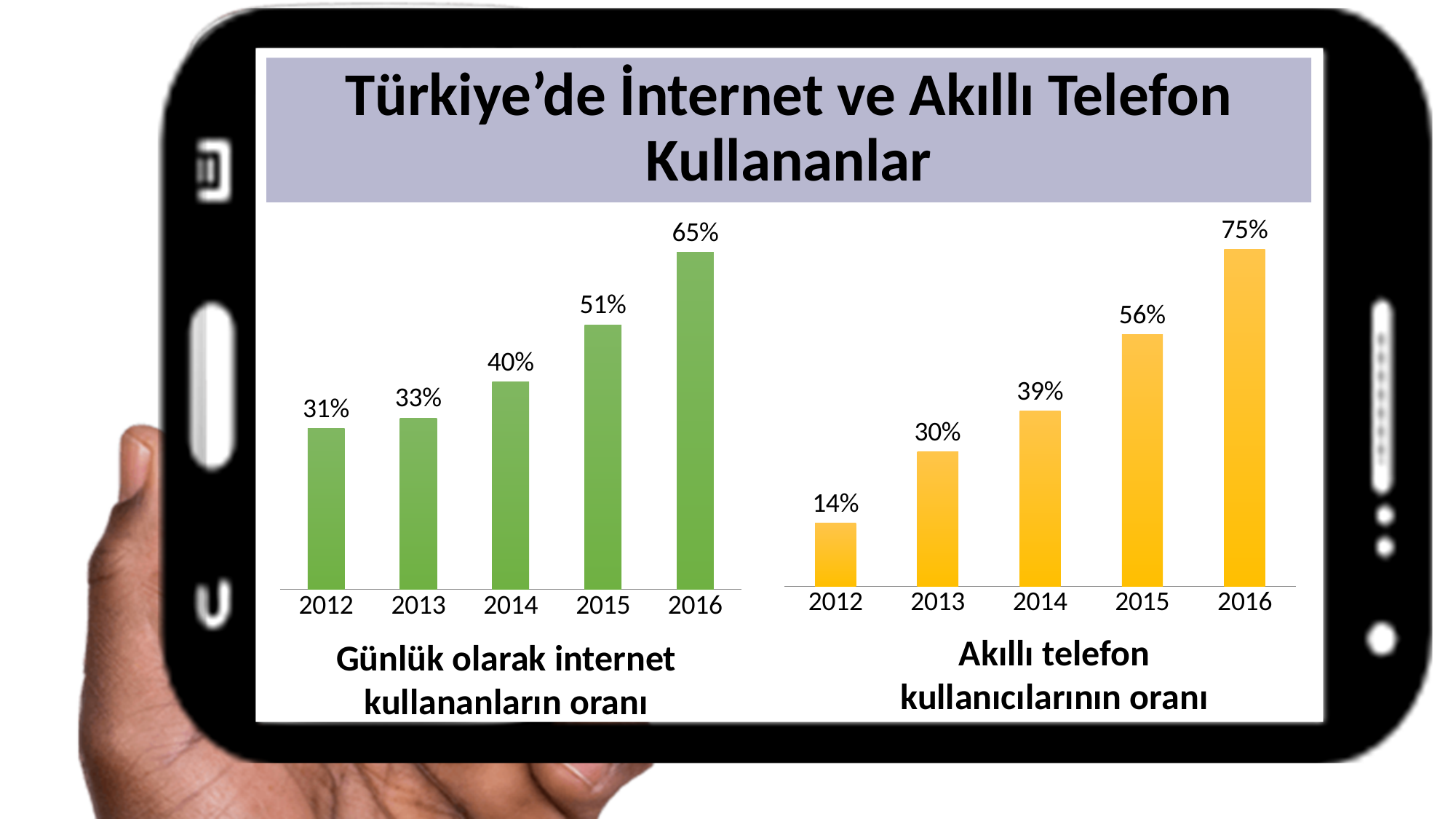
In the right chart (Akıllı telefon kullanıcılarının oranı), what is the value for 2013? 30% In the right chart (Akıllı telefon kullanıcılarının oranı), what is the difference between the 2016 and 2015 values? 19% Which is larger: the 2016 value in the left chart (Günlük olarak internet kullananların oranı) or the 2016 value in the right chart (Akıllı telefon kullanıcılarının oranı)? The right chart (Akıllı telefon kullanıcılarının oranı), 75% What kind of chart is the left chart (Günlük olarak internet kullananların oranı)? Bar chart What colour are the bars in the right chart (Akıllı telefon kullanıcılarının oranı)? Yellow/orange In the right chart (Akıllı telefon kullanıcılarının oranı), do the values rise or fall from 2012 to 2016? Rise In the right chart (Akıllı telefon kullanıcılarının oranı), how many years are shown on the x axis? 5 What is the title shown at the top of the slide? Türkiye'de İnternet ve Akıllı Telefon Kullananlar In the left chart (Günlük olarak internet kullananların oranı), what is the value for 2014? 40% In the left chart (Günlük olarak internet kullananların oranı), what is the difference between the 2016 and 2012 values? 34% In the left chart (Günlük olarak internet kullananların oranı), which year has the highest value? 2016 In the right chart (Akıllı telefon kullanıcılarının oranı), which year has the lowest value? 2012